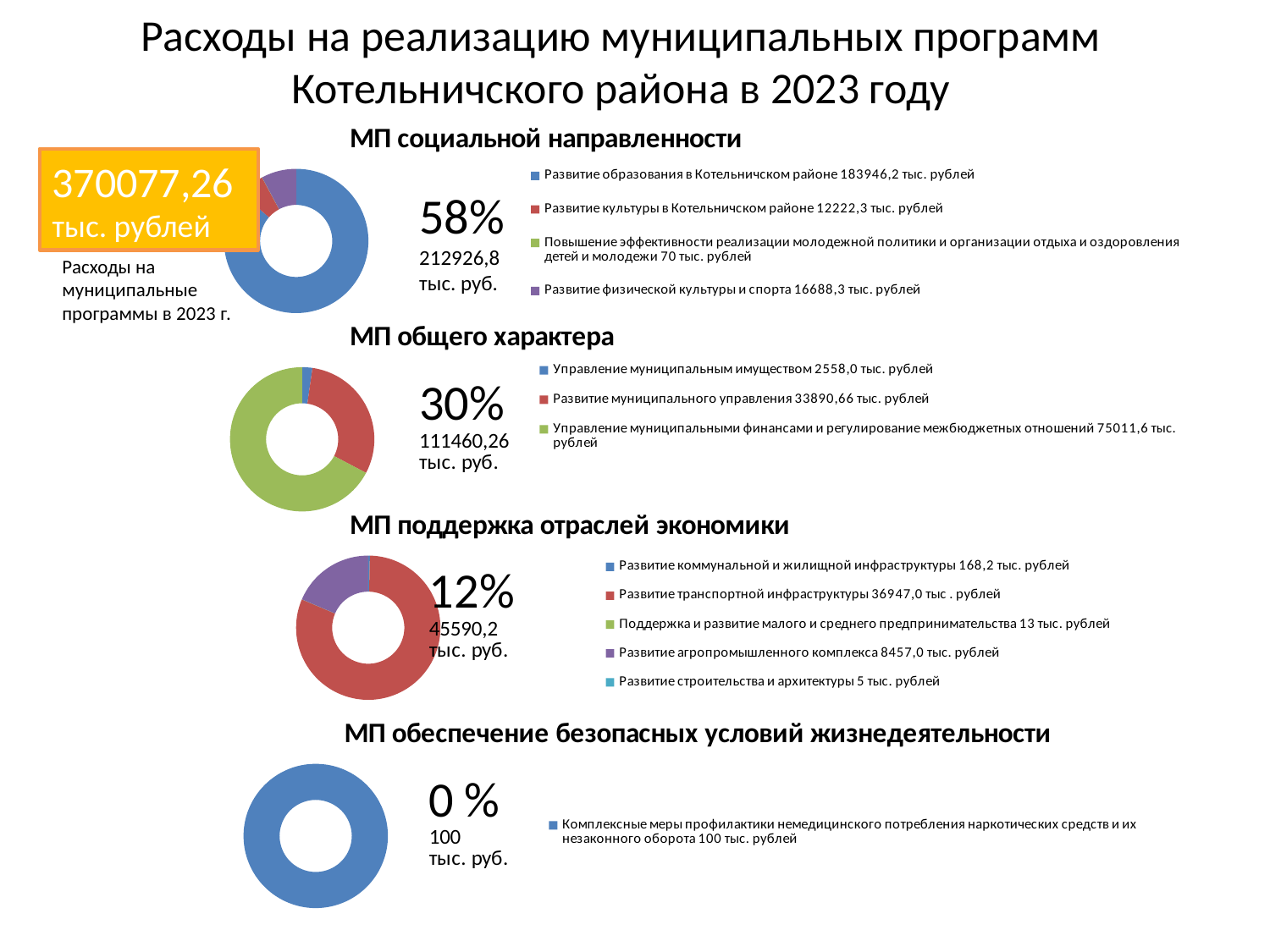
How many categories does the legend of the 'МП поддержка отраслей экономики' chart list? 5 What kind of chart is used for 'МП социальной направленности'? Doughnut chart In the 'МП социальной направленности' chart, which category has the smallest value? Повышение эффективности реализации молодежной политики и организации отдыха и оздоровления детей и молодежи How many categories does the legend of the 'МП общего характера' chart list? 3 In the 'МП общего характера' chart, what is the difference between 'Управление муниципальными финансами и регулирование межбюджетных отношений' and 'Развитие муниципального управления'? 41120,94 тыс. рублей What percentage is shown next to the 'МП обеспечение безопасных условий жизнедеятельности' chart? 0 % In the 'МП поддержка отраслей экономики' chart, what is the value for 'Развитие строительства и архитектуры'? 5 тыс. рублей In the 'МП социальной направленности' chart, what is the value for 'Развитие образования в Котельничском районе'? 183946,2 тыс. рублей In the 'МП поддержка отраслей экономики' chart, which is larger: 'Развитие транспортной инфраструктуры' or 'Развитие агропромышленного комплекса'? Развитие транспортной инфраструктуры In the 'МП общего характера' chart, what is the value for 'Развитие муниципального управления'? 33890,66 тыс. рублей In the 'МП социальной направленности' chart, what is the difference between 'Развитие образования в Котельничском районе' and 'Развитие культуры в Котельничском районе'? 171723,9 тыс. рублей In the 'МП общего характера' chart, which category has the largest value? Управление муниципальными финансами и регулирование межбюджетных отношений